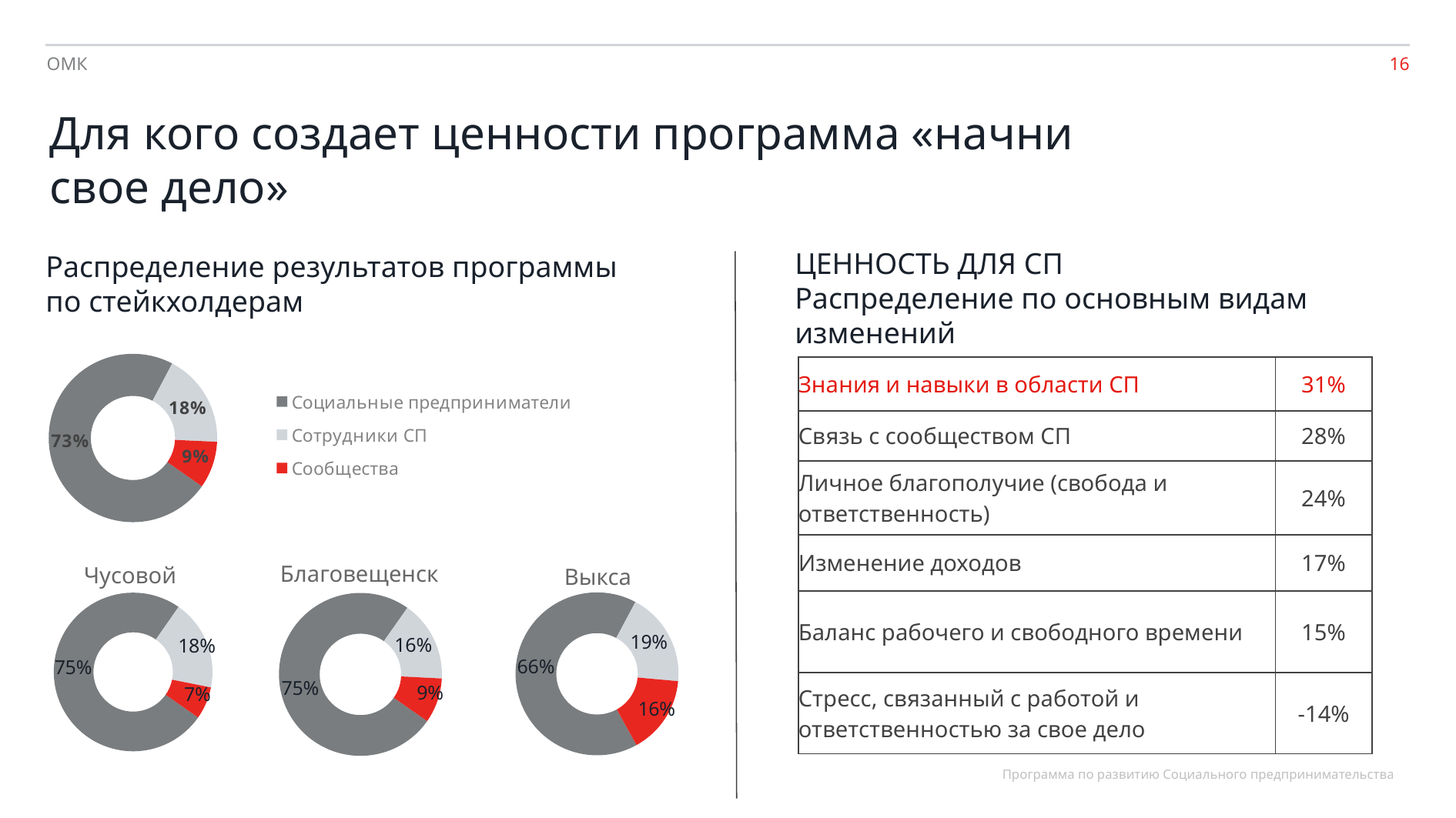
How many categories does the legend of the stakeholder donut charts list? 3 In the Благовещенск chart, what share goes to Социальные предприниматели? 75% In the top-left donut chart (overall distribution by stakeholders), what share goes to Социальные предприниматели? 73% What type of chart is used to show the distribution of program results by stakeholders? Donut (pie) chart In the top-left donut chart (overall distribution by stakeholders), what share goes to Сообщества? 9% In the legend of the stakeholder charts, which category is shown in red? Сообщества In the Выкса chart, which category has the largest share? Социальные предприниматели In the Выкса chart, what share goes to Сообщества? 16% Which chart shows a larger share for Сообщества, Чусовой or Выкса? Выкса In the Чусовой chart, what share goes to Сотрудники СП? 18% In the Выкса chart, what is the difference in percentage points between Сотрудники СП and Сообщества? 3 In the Чусовой chart, which category has the smallest share? Сообщества